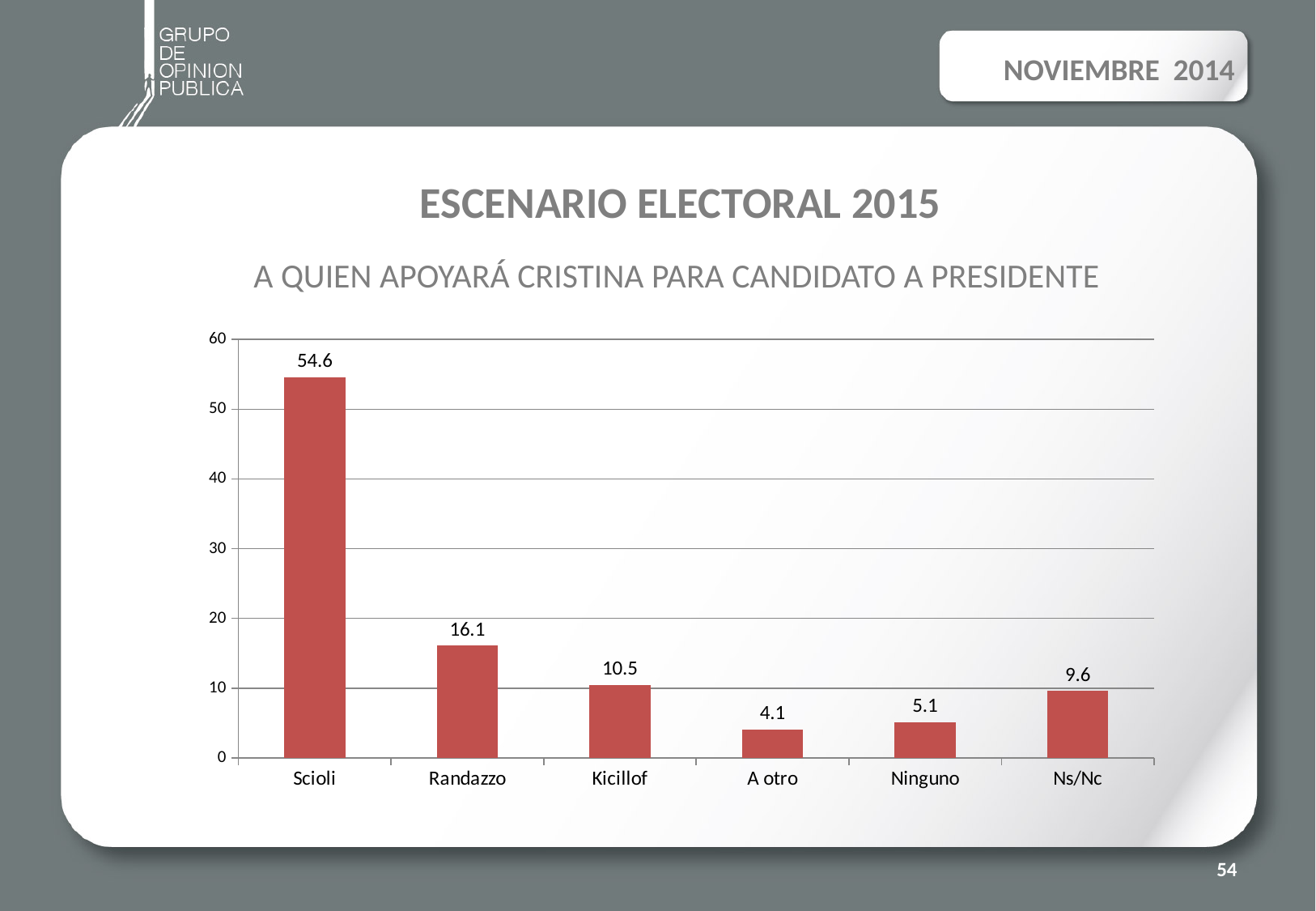
What is the value for Ns/Nc? 9.6 Is the value for Scioli greater or less than 50? greater Which category has the highest value? Scioli What is the value for Kicillof? 10.5 What is the difference between the values for Ninguno and A otro? 1.0 What is the value for Scioli? 54.6 Which is larger, the value for Kicillof or the value for Ns/Nc? Kicillof What is the difference between the values for Scioli and Randazzo? 38.5 What kind of chart is shown on the slide? bar chart How many categories are shown on the x axis? 6 Which category has the lowest value? A otro What is the value for Randazzo? 16.1